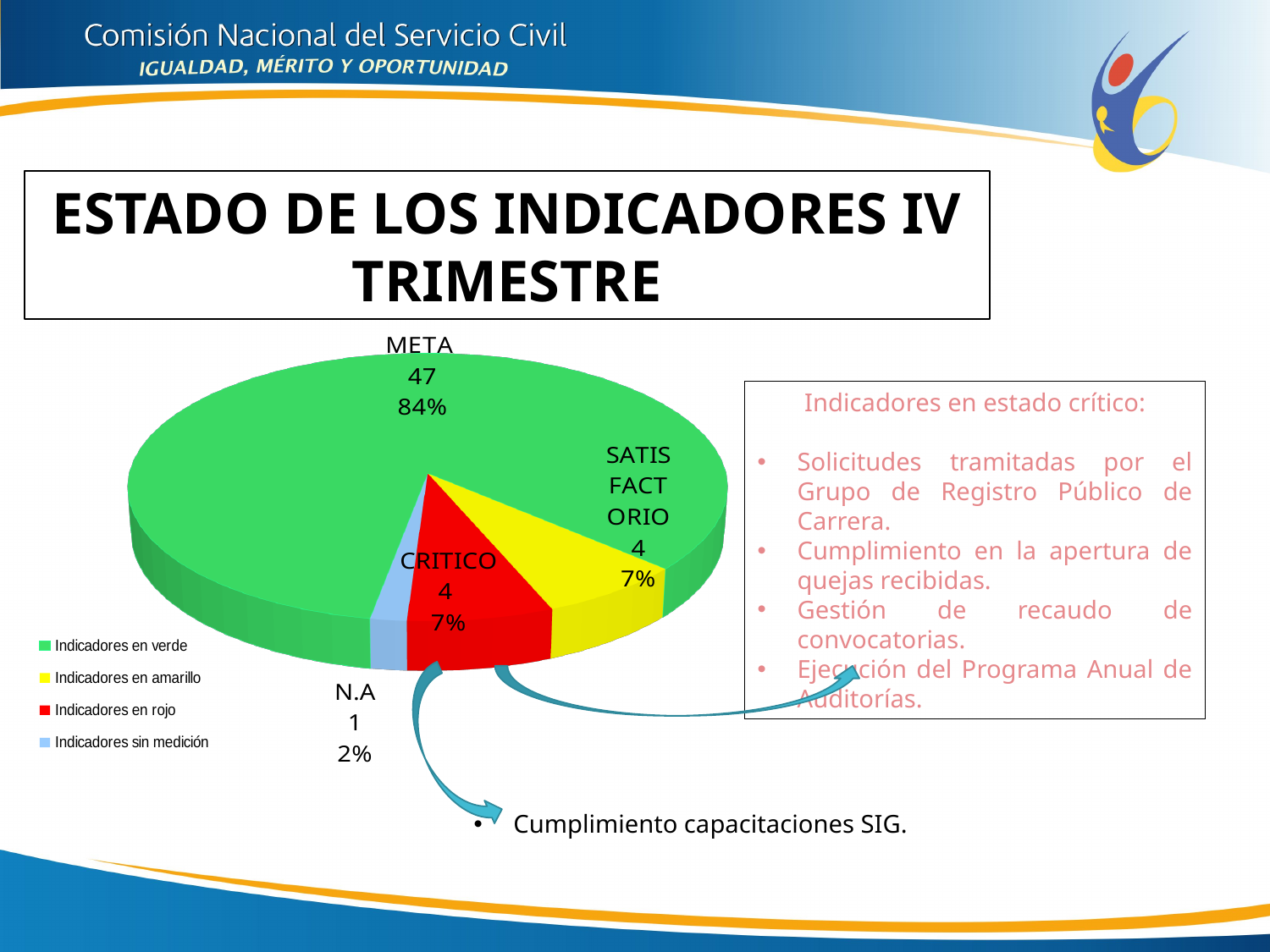
What kind of chart is shown on the slide? Pie chart What is the value shown for the CRITICO slice? 4 What percentage is shown for the META slice? 84% What is the value shown for the N.A slice? 1 What percentage is shown for the SATISFACTORIO slice? 7% What is the value shown for the META slice? 47 What percentage is shown for the N.A slice? 2% What is the difference between the META value and the CRITICO value? 43 Which slice of the pie is the largest? META How many slices does the pie chart have? 4 Which slice of the pie is the smallest? N.A How many entries does the legend list? 4